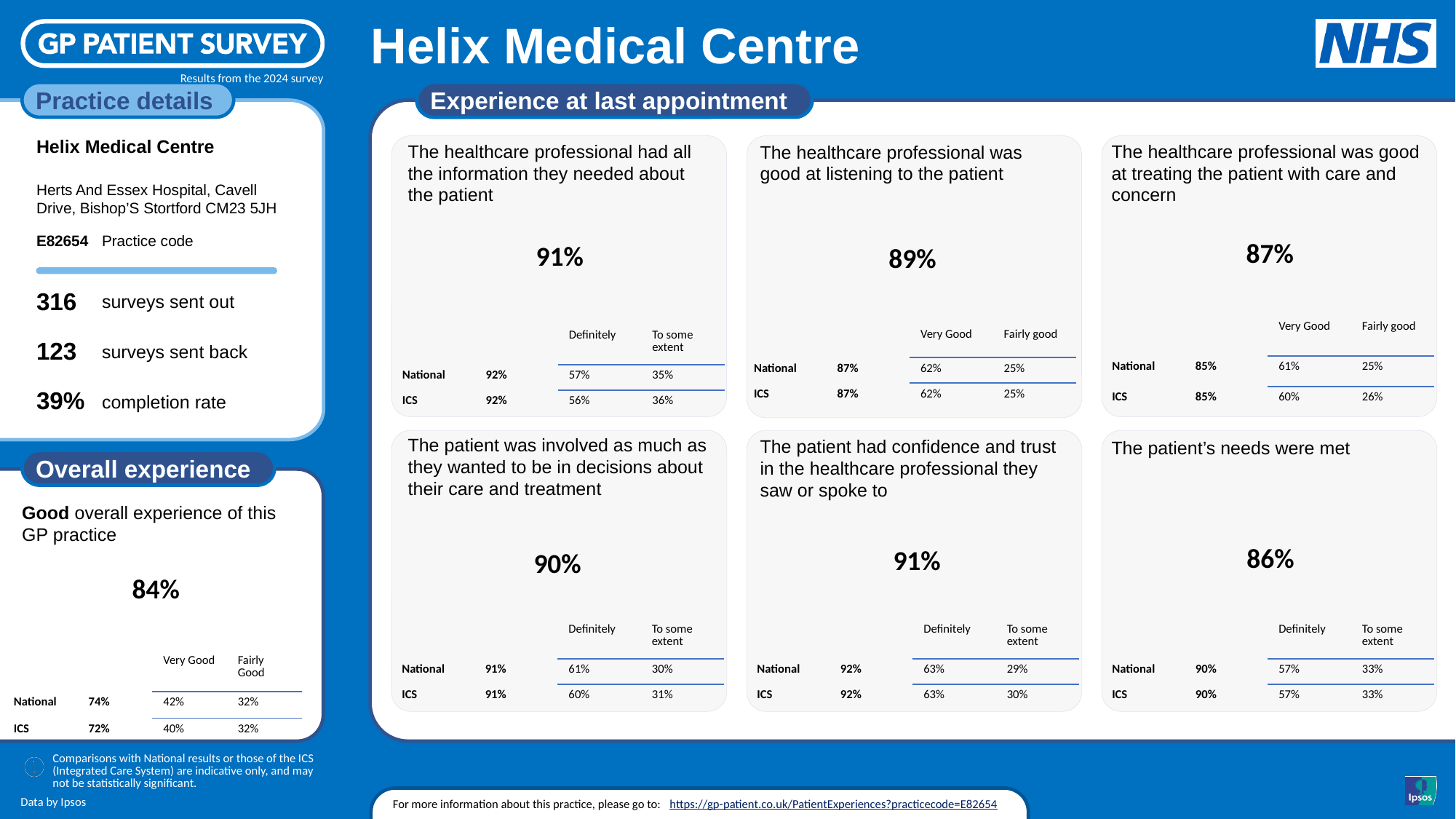
In the panel 'The patient's needs were met', what is the difference between the National value (90%) and the practice's value (86%)? 4% In the 'Overall experience' section, what percentage of patients reported a good overall experience of this GP practice? 84% How many panels are shown under the 'Experience at last appointment' heading? 6 In the 'Overall experience' section, what is the difference between the practice's value (84%) and the ICS value (72%)? 12% In the panel 'The patient had confidence and trust in the healthcare professional they saw or spoke to', which is larger: the practice's value or the National value? National In the panel 'The healthcare professional had all the information they needed about the patient', what is the practice's percentage? 91% In the panel 'The healthcare professional was good at listening to the patient', what is the National 'Very Good' value? 62% In the panel 'The healthcare professional was good at treating the patient with care and concern', what is the ICS 'Fairly good' value? 26% In the 'Overall experience' section, what is the National value for good overall experience? 74% Among the six 'Experience at last appointment' panels, which has the lowest practice percentage? The patient's needs were met In the 'Overall experience' section, what is the ICS 'Very Good' value? 40% In the panel 'The patient was involved as much as they wanted to be in decisions about their care and treatment', what is the practice's percentage? 90%